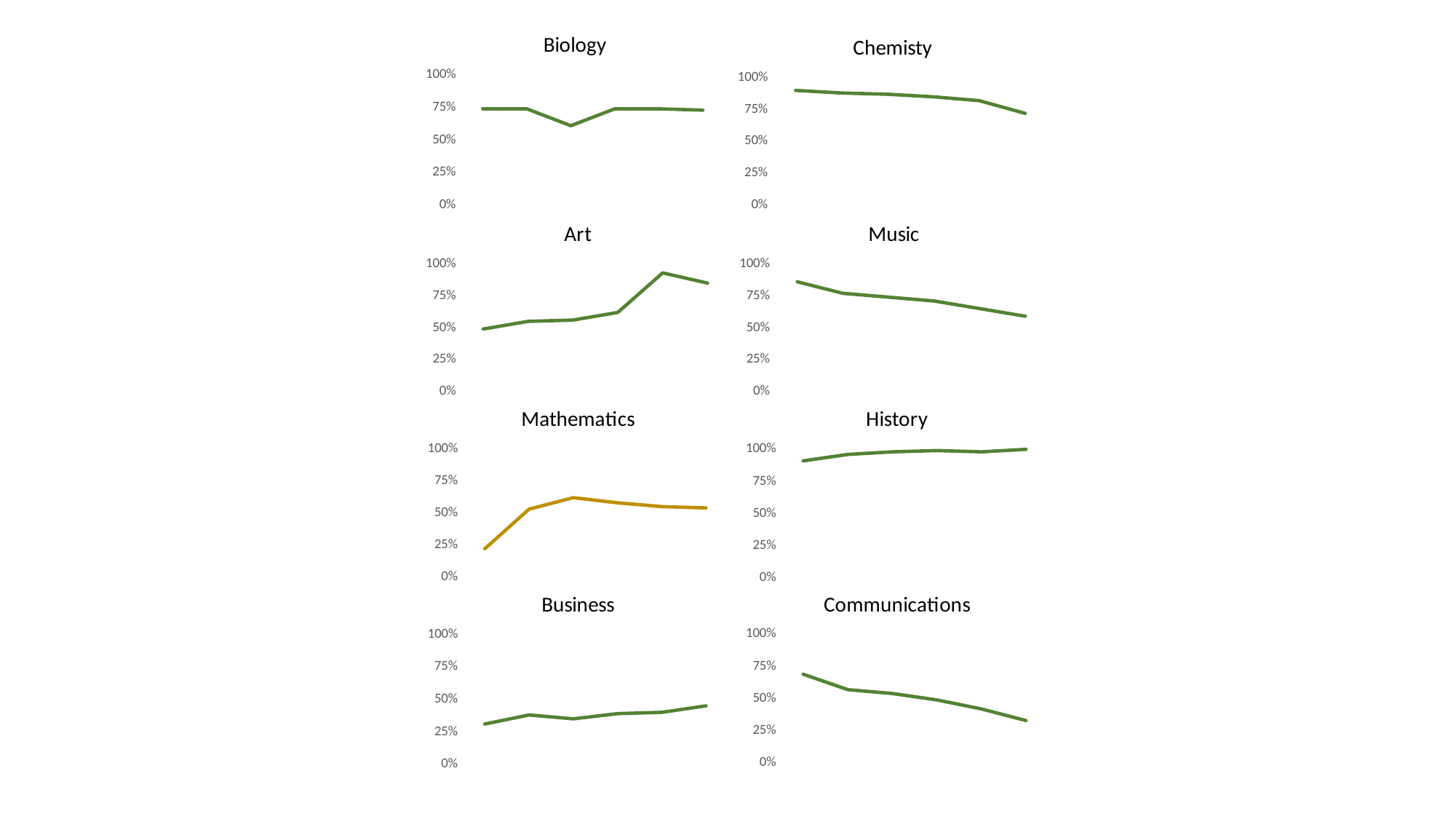
How many data points are plotted in the Music chart? 6 In the History chart, do the values generally rise or fall along the x axis? rise In the Communications chart, do the values rise or fall along the x axis? fall In the Art chart, is the value of the last point greater or less than 75%? greater In the Mathematics chart, is the value of the first point greater or less than 25%? less In the Business chart, is the value of the first point greater or less than 50%? less How many charts are shown on the slide? 8 What kind of chart is the Biology chart? line chart In the Music chart, do the values rise or fall along the x axis? fall Which chart on the slide has its line drawn in orange rather than green? Mathematics